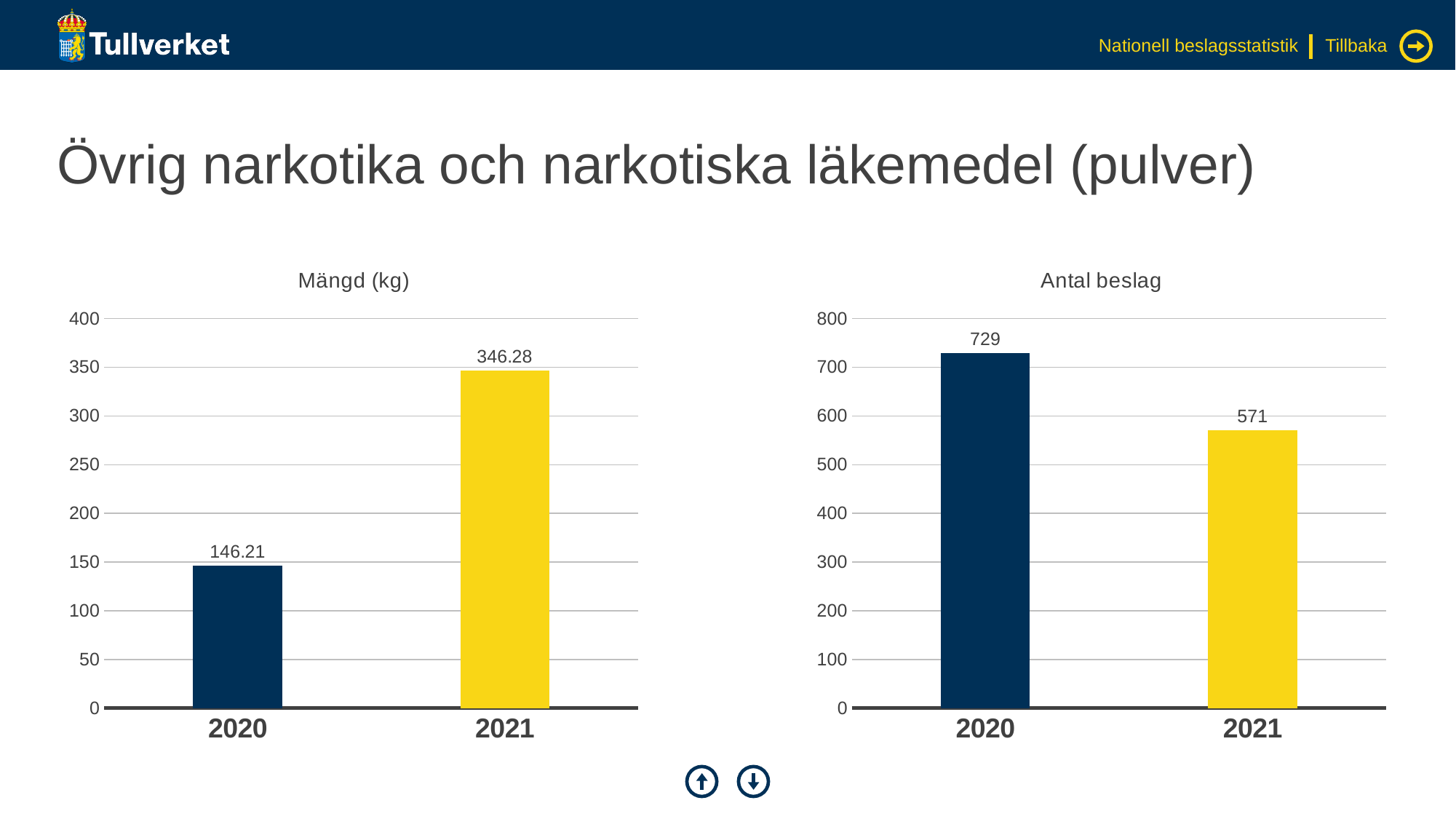
In the 'Antal beslag' chart, is the value for 2020 greater or less than 700? greater In the 'Antal beslag' chart, what is the difference between the values for 2020 and 2021? 158 In the 'Antal beslag' chart, what is the value for 2021? 571 In the 'Mängd (kg)' chart, what is the difference between the values for 2021 and 2020? 200.07 In the 'Mängd (kg)' chart, what is the value for 2021? 346.28 In the 'Mängd (kg)' chart, what is the value for 2020? 146.21 In the 'Mängd (kg)' chart, which year has the highest value? 2021 In the 'Antal beslag' chart, what is the value for 2020? 729 In the 'Mängd (kg)' chart, do the values rise or fall from 2020 to 2021? rise What kind of chart is the 'Antal beslag' chart? bar chart How many categories are shown on the x axis of the 'Mängd (kg)' chart? 2 In the 'Antal beslag' chart, which year has the lowest value? 2021